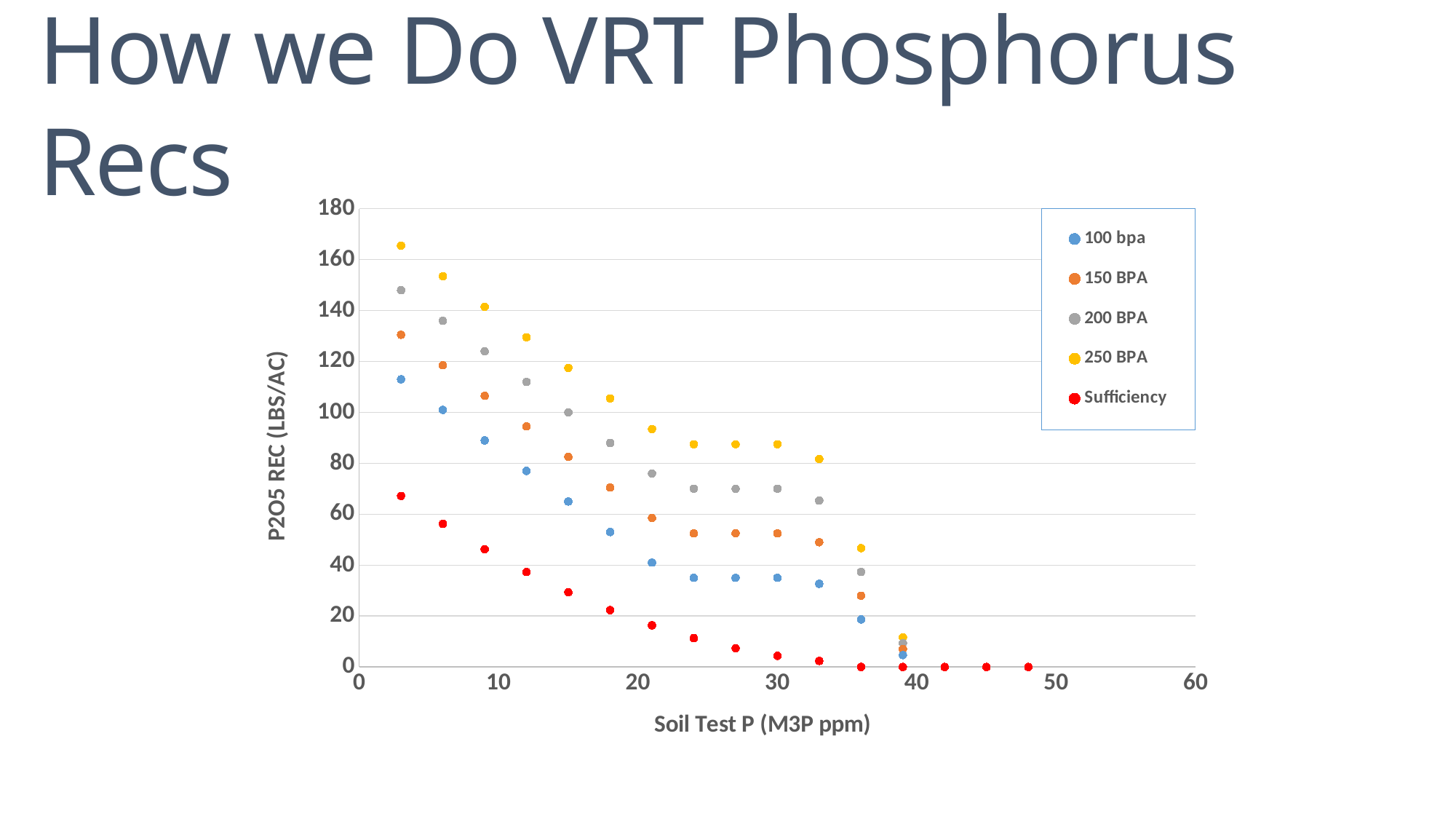
What kind of chart is shown on the slide? scatter chart Is the value for 250 BPA at a soil test P of 3 greater or less than 140? greater As soil test P increases along the x axis, do the P2O5 recommendation values rise or fall? fall What is the title of the x axis? Soil Test P (M3P ppm) Which series has the lowest value at a soil test P of 3? Sufficiency At a soil test P of 12, which is larger: the value for 250 BPA or the value for 100 bpa? 250 BPA What are the series names listed in the legend? 100 bpa, 150 BPA, 200 BPA, 250 BPA, Sufficiency Is the value for Sufficiency at a soil test P of 3 greater or less than 60? greater Is the value for Sufficiency at a soil test P of 36 greater or less than 20? less Which series has the highest value at a soil test P of 3? 250 BPA How many series does the legend list? 5